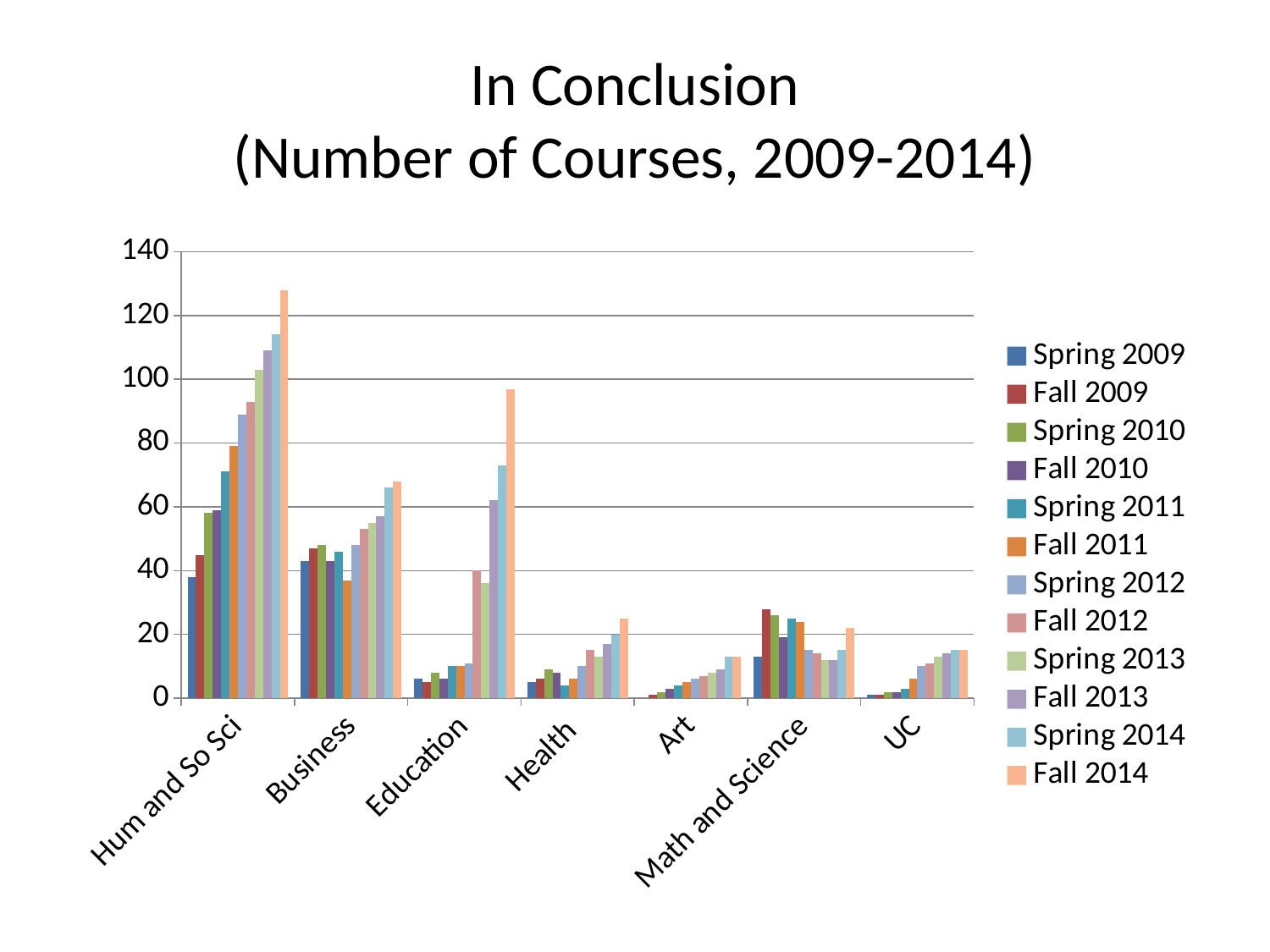
Is the Fall 2014 value for Hum and So Sci greater or less than 120? greater How many series does the legend list? 12 Within the Hum and So Sci category, which series has the highest value? Fall 2014 Do the values for Hum and So Sci generally rise or fall from Spring 2009 to Fall 2014? rise Is the Spring 2014 value for Hum and So Sci greater or less than 100? greater For Education, which is larger: the Spring 2014 value or the Fall 2014 value? Fall 2014 Which category has the tallest bar in the chart? Hum and So Sci Within the Hum and So Sci category, which series has the lowest value? Spring 2009 What kind of chart is shown on the slide? bar chart How many categories are shown on the x axis? 7 Is the Fall 2014 value for Education greater or less than 100? less